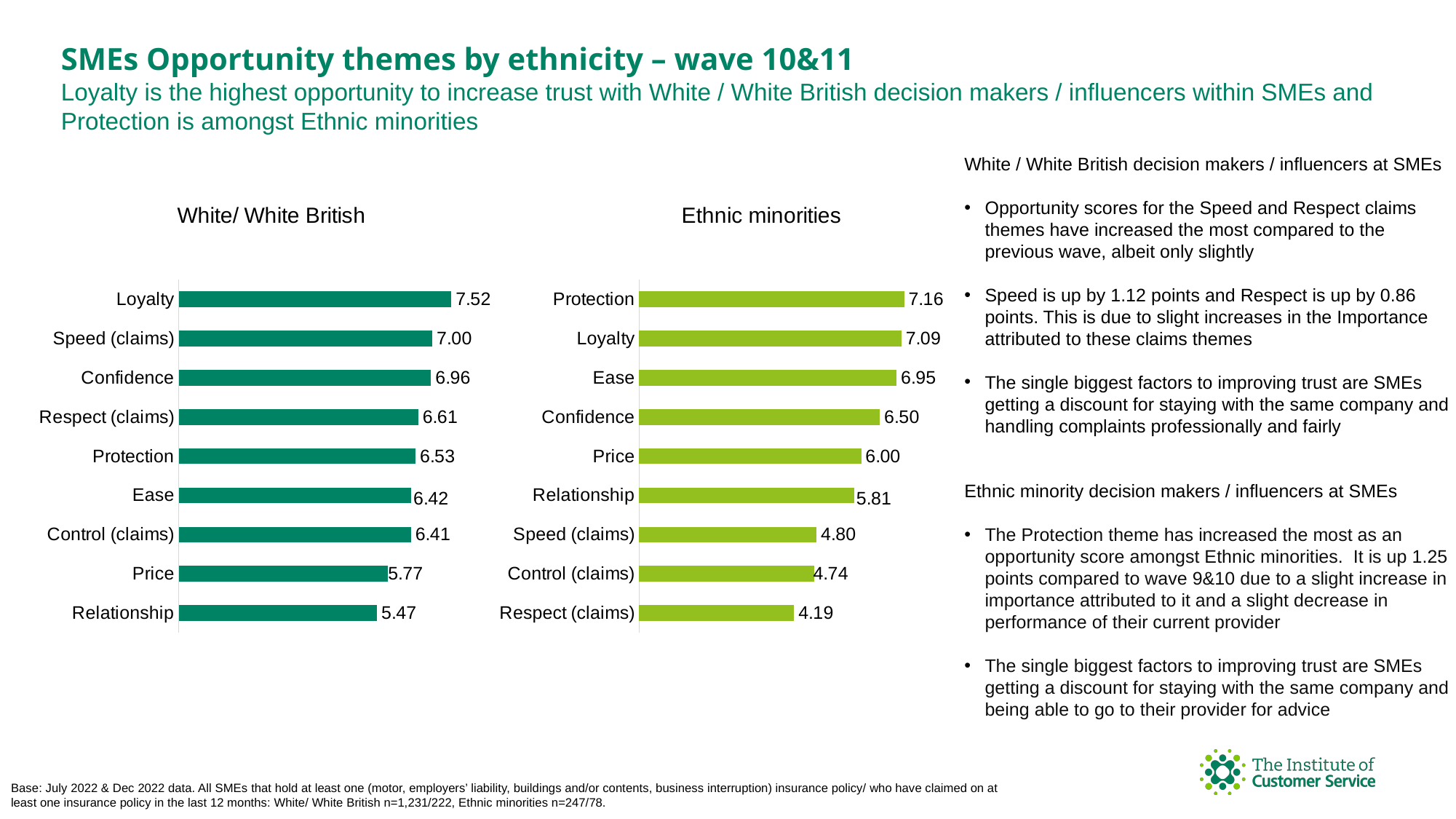
In the 'White/ White British' chart, what is the difference between Loyalty and Relationship? 2.05 What kind of chart is the 'Ethnic minorities' chart? Bar chart In the 'White/ White British' chart, which category has the lowest value? Relationship What colour are the bars in the 'White/ White British' chart? Dark green In the 'Ethnic minorities' chart, what is the difference between Protection and Respect (claims)? 2.97 In the 'Ethnic minorities' chart, what is the value for Speed (claims)? 4.80 How many categories are shown in the 'White/ White British' chart? 9 In the 'Ethnic minorities' chart, which category has the lowest value? Respect (claims) In the 'White/ White British' chart, what is the value for Loyalty? 7.52 In the 'Ethnic minorities' chart, what is the value for Protection? 7.16 Which is larger: Price in the 'White/ White British' chart or Price in the 'Ethnic minorities' chart? Ethnic minorities In the 'Ethnic minorities' chart, which category has the highest value? Protection